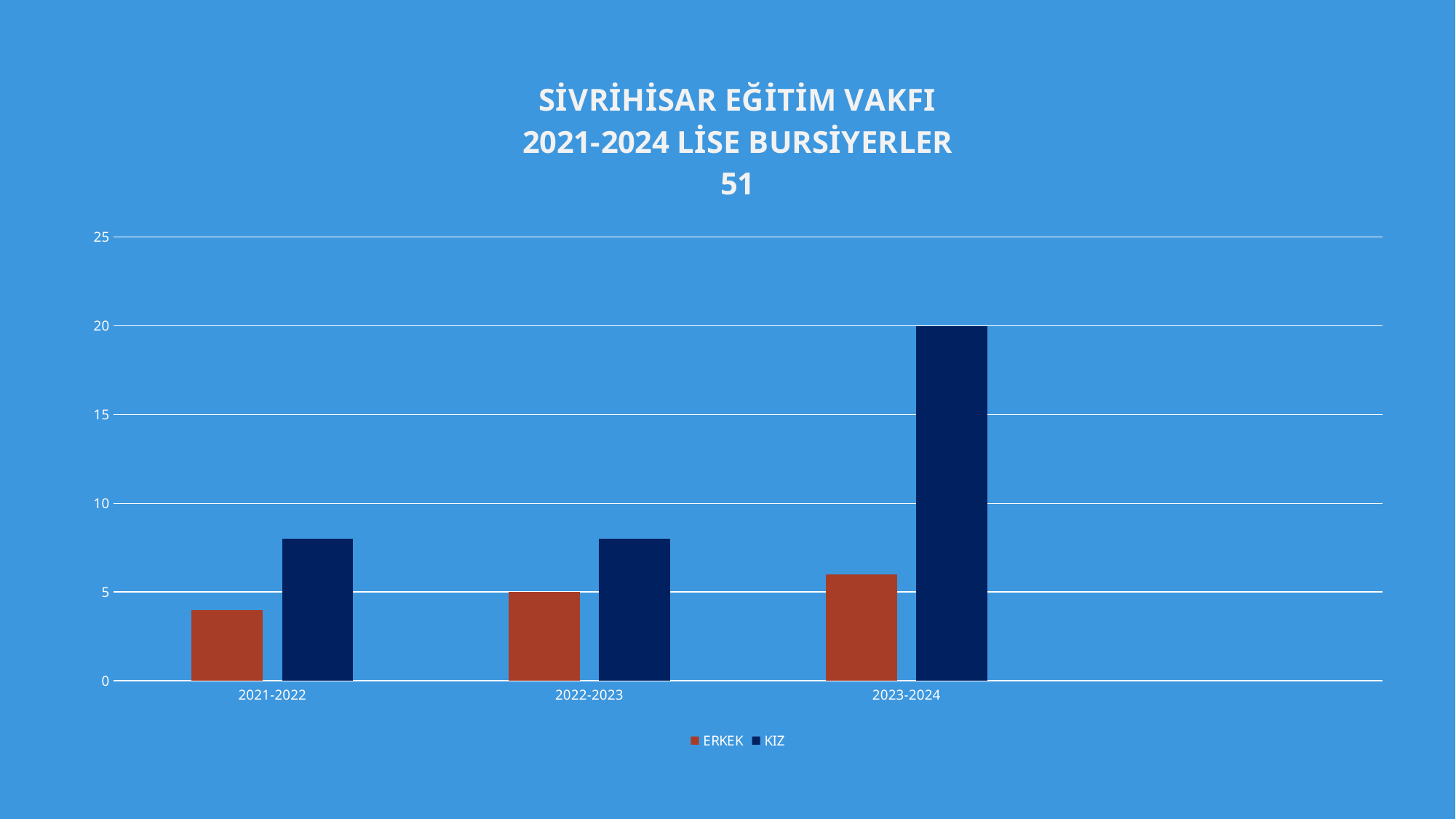
What type of chart is shown on the slide? Bar chart What are the two legend entries of the chart? ERKEK and KIZ How many academic-year categories are shown on the x axis? 3 Is the value for KIZ in 2021-2022 greater or less than 10? less Which bar is the lowest in the chart? ERKEK in 2021-2022 Do the ERKEK values rise or fall from 2021-2022 to 2023-2024? rise Is the value for ERKEK in 2021-2022 greater or less than 5? less Which bar is the highest in the chart? KIZ in 2023-2024 How many series does the legend list? 2 In 2023-2024, which is larger, ERKEK or KIZ? KIZ What is the value for KIZ in 2023-2024? 20 What is the value for ERKEK in 2022-2023? 5